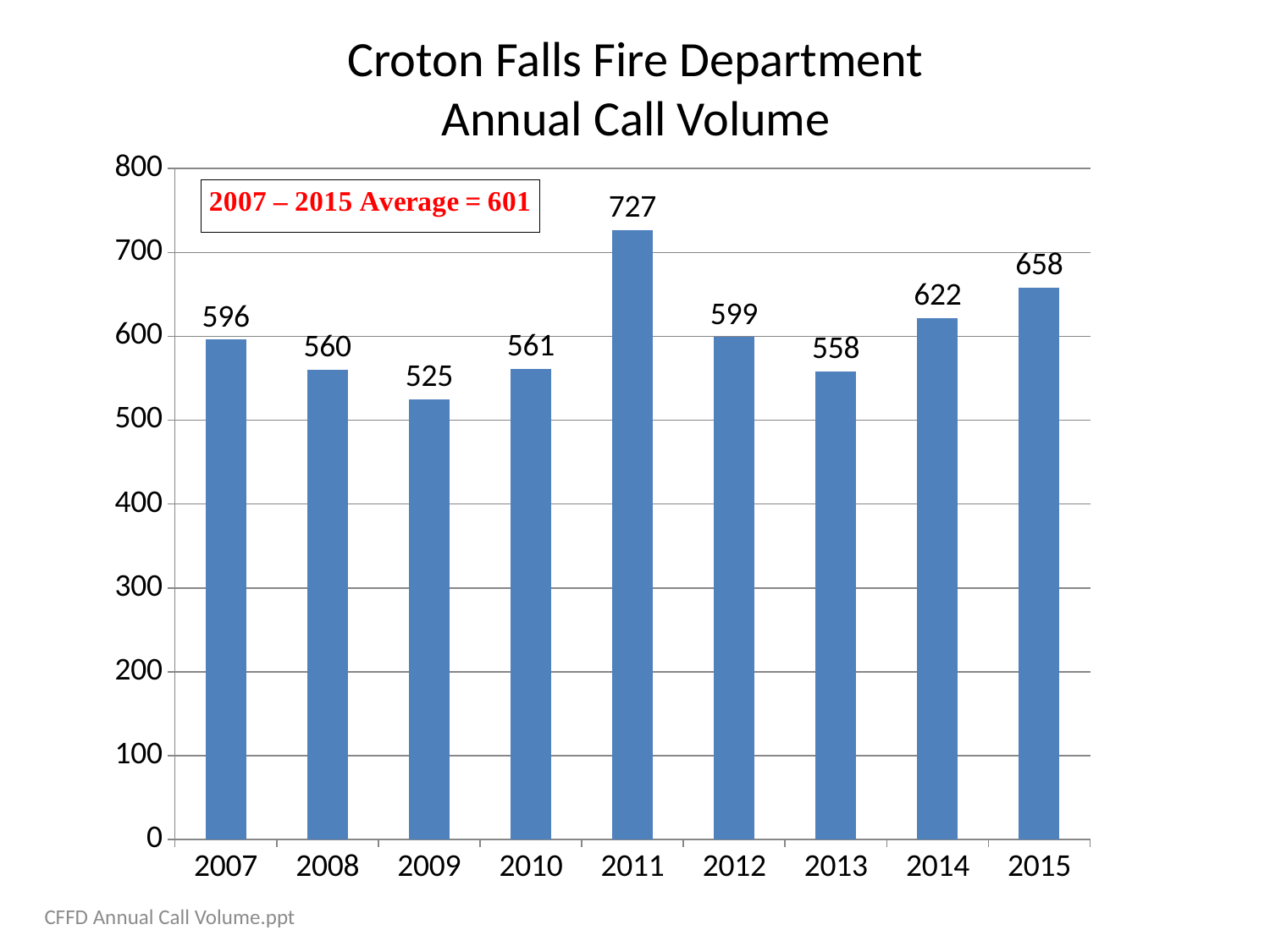
What kind of chart is shown on the slide? bar chart What is the difference in call volume between 2011 and 2009? 202 What was the annual call volume in 2009? 525 Is the call volume for 2011 greater or less than 700? greater What is the 2007 – 2015 average call volume stated on the chart? 601 Which year had a higher call volume, 2007 or 2013? 2007 Which year had the highest annual call volume? 2011 What is the difference in call volume between 2015 and 2014? 36 What was the annual call volume in 2015? 658 Which year had the lowest annual call volume? 2009 How many years are shown on the chart? 9 What was the annual call volume in 2011? 727